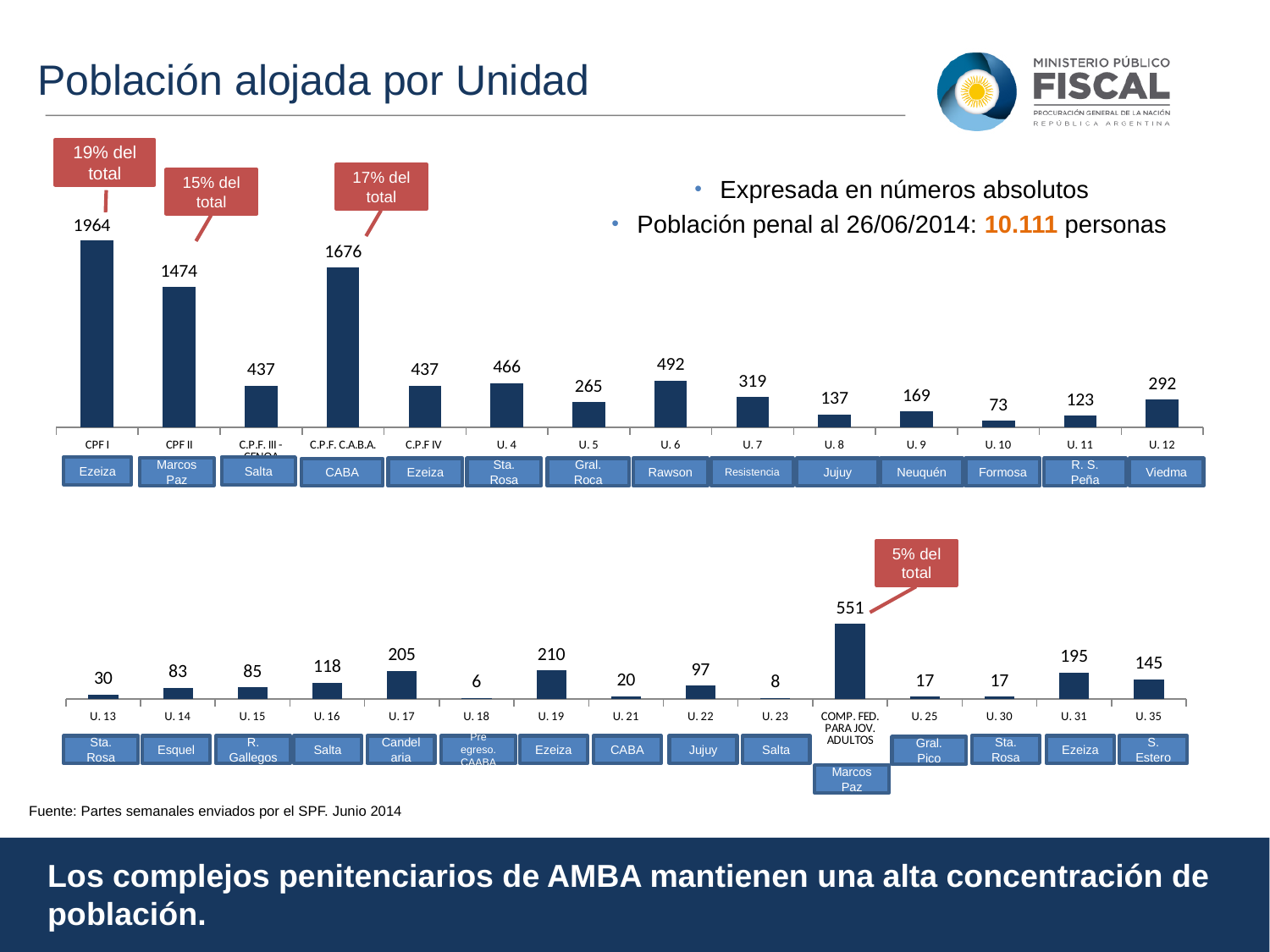
How many units are shown in the bottom chart? 15 What type of chart is the top chart? Bar chart In the bottom chart, what is the difference between U. 31 and U. 35? 50 In the top chart, what is the value for CPF I? 1964 How many units are shown in the top chart? 14 In the bottom chart, what is the value for U. 19? 210 In the top chart, which unit has the lowest value? U. 10 In the top chart, what is the difference between CPF I and CPF II? 490 In the bottom chart, which unit has the highest value? COMP. FED. PARA JOV. ADULTOS In the bottom chart, which unit has the lowest value? U. 18 In the top chart, which is larger, U. 6 or U. 7? U. 6 In the top chart, what is the value for C.P.F. C.A.B.A.? 1676